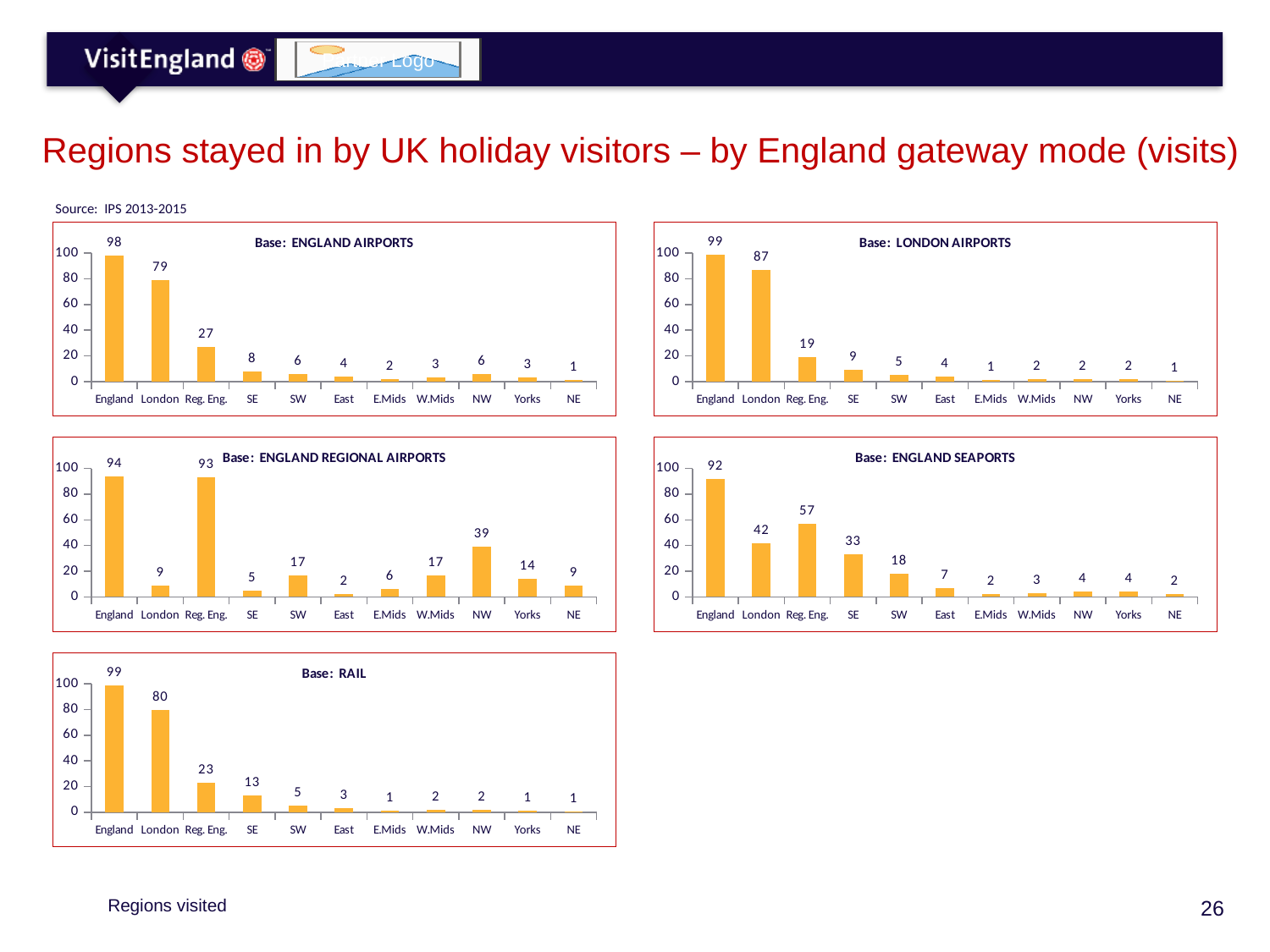
In the 'Base: ENGLAND REGIONAL AIRPORTS' chart, what is the difference between the values for NW and London? 30 In the 'Base: ENGLAND REGIONAL AIRPORTS' chart, which region other than England has the highest value? Reg. Eng. In the 'Base: RAIL' chart, which region has the lowest value? E.Mids, Yorks and NE (tied at 1) In the 'Base: ENGLAND SEAPORTS' chart, what is the value for SE? 33 What type of chart is the 'Base: RAIL' chart? Bar chart How many charts are shown on the slide? 5 In the 'Base: LONDON AIRPORTS' chart, what is the value for Reg. Eng.? 19 How many categories are shown on the x axis of the 'Base: LONDON AIRPORTS' chart? 11 In the 'Base: ENGLAND AIRPORTS' chart, what is the difference between the values for England and London? 19 In the 'Base: ENGLAND AIRPORTS' chart, what is the value for London? 79 In the 'Base: ENGLAND SEAPORTS' chart, which is larger, the value for London or the value for Reg. Eng.? Reg. Eng. In the 'Base: RAIL' chart, what is the value for SE? 13